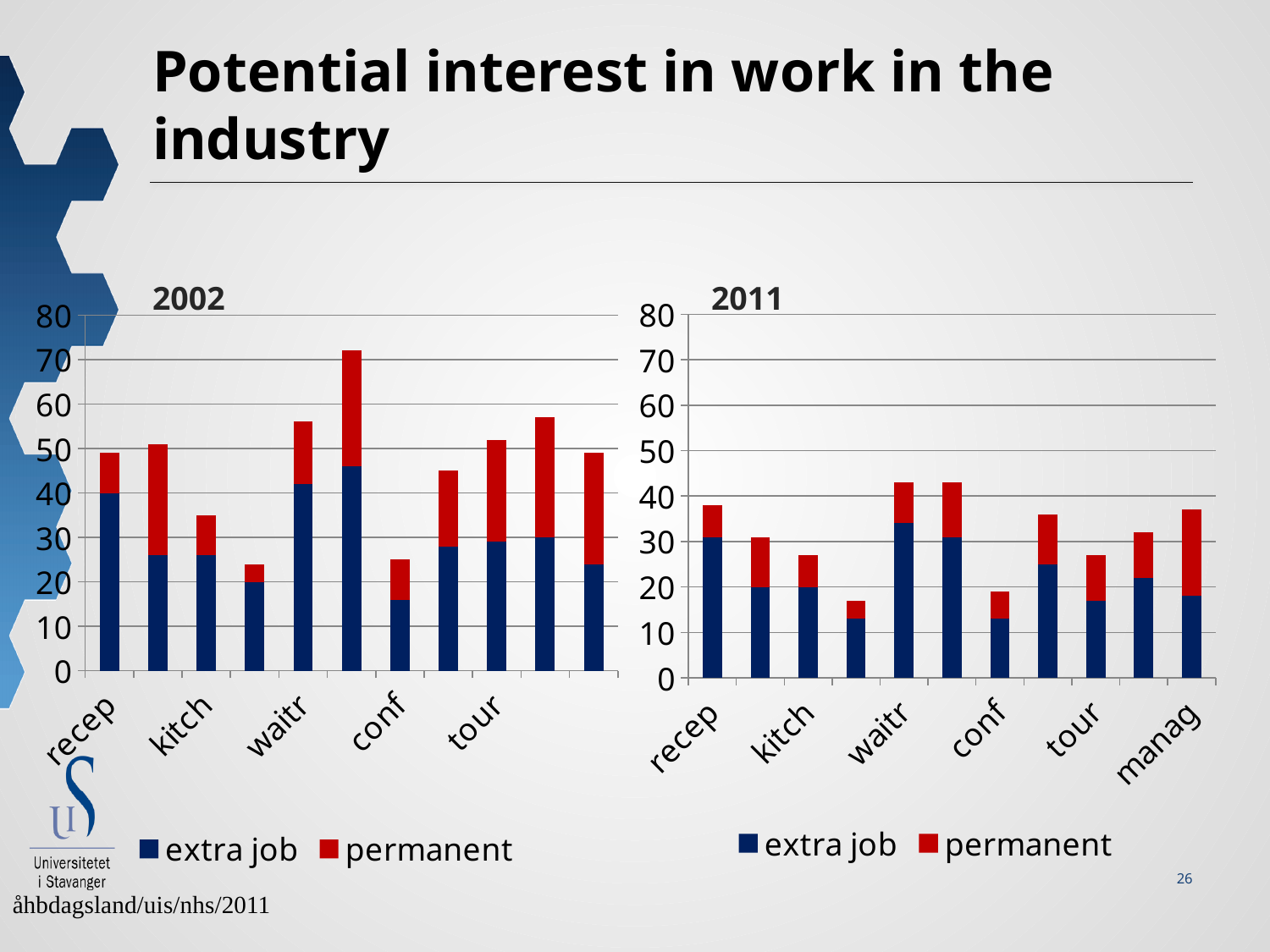
In the 2011 chart, is the total value for waitr greater or less than 40? greater What kind of chart is the 2002 chart? stacked bar chart Which chart shows the larger total bar for recep, the 2002 chart or the 2011 chart? 2002 In the 2011 chart, is the total value for manag greater or less than 30? greater How many series does the legend of the 2011 chart list? 2 In the 2011 chart, which has the larger total bar, waitr or conf? waitr In the 2002 chart, which has the larger total bar, waitr or kitch? waitr In the 2002 chart, is the total value for kitch greater or less than 40? less What are the two legend entries of the 2002 chart? extra job, permanent